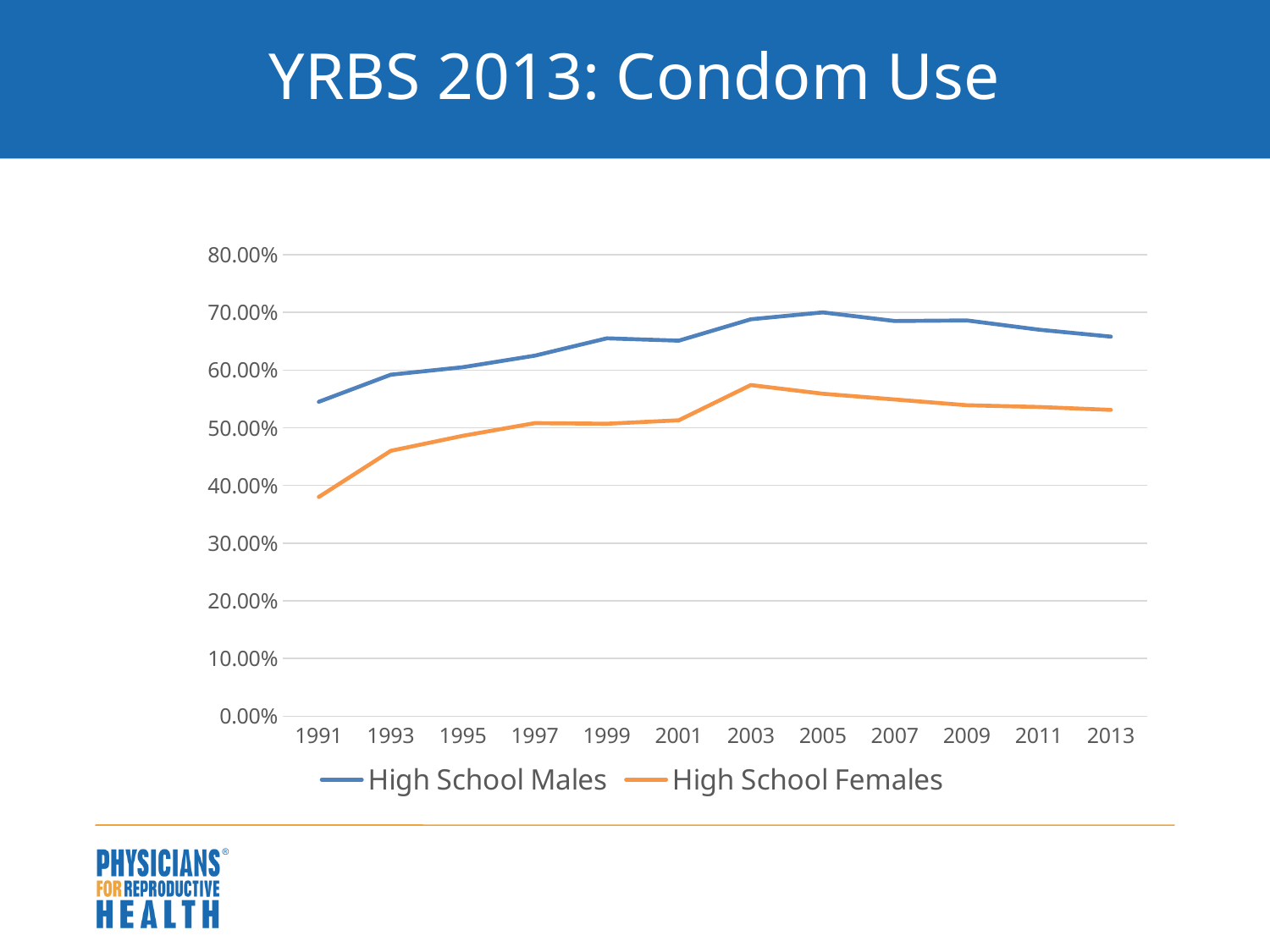
Is the value for High School Females in 1991 greater or less than 40.00%? less Is the value for High School Males in 1991 greater or less than 50.00%? greater Does the High School Females line rise or fall from 1991 to 2003? rise Is the value for High School Females in 2003 greater or less than 50.00%? greater How many series does the legend list? 2 In which year is the High School Females value highest? 2003 What kind of chart is shown on the slide? Line chart Which series has the higher value in 2013, High School Males or High School Females? High School Males What is the title of the chart slide? YRBS 2013: Condom Use How many years are plotted along the x axis? 12 In which year is the High School Females value lowest? 1991